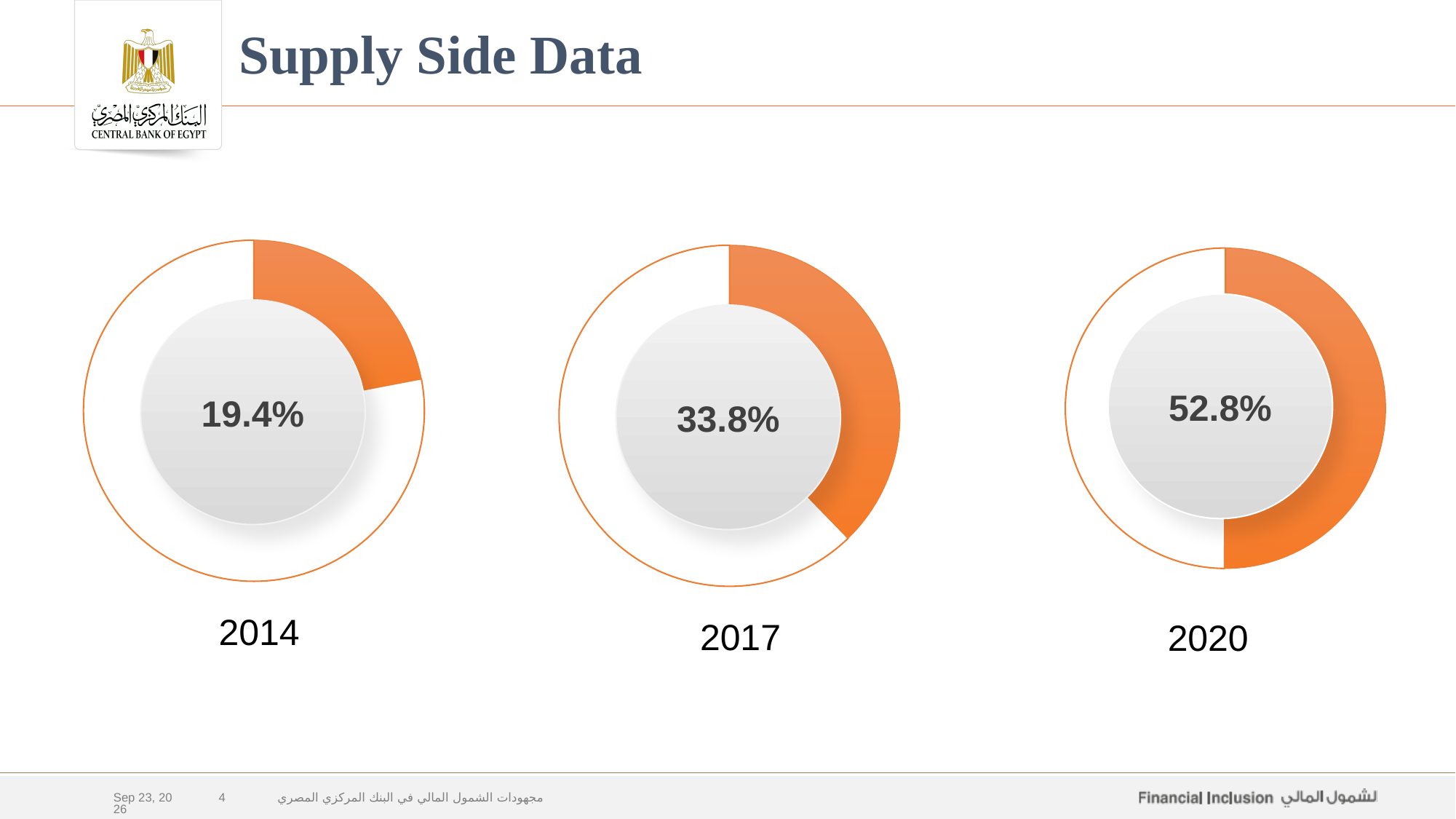
How many charts are shown on the slide? 3 What value is shown in the 2017 chart? 33.8% What is the difference between the value in the 2020 chart and the value in the 2014 chart? 33.4% What is the difference between the value in the 2017 chart and the value in the 2014 chart? 14.4% Which is larger, the value in the 2017 chart or the value in the 2020 chart? 2020 What value is shown in the 2020 chart? 52.8% What is the title of the slide containing the three charts? Supply Side Data Do the values rise or fall from the 2014 chart to the 2020 chart? Rise What kind of chart is used for the 2014, 2017 and 2020 figures? Donut (pie) chart Across the three charts, which year shows the highest value? 2020 What value is shown in the 2014 chart? 19.4% Across the three charts, which year shows the lowest value? 2014